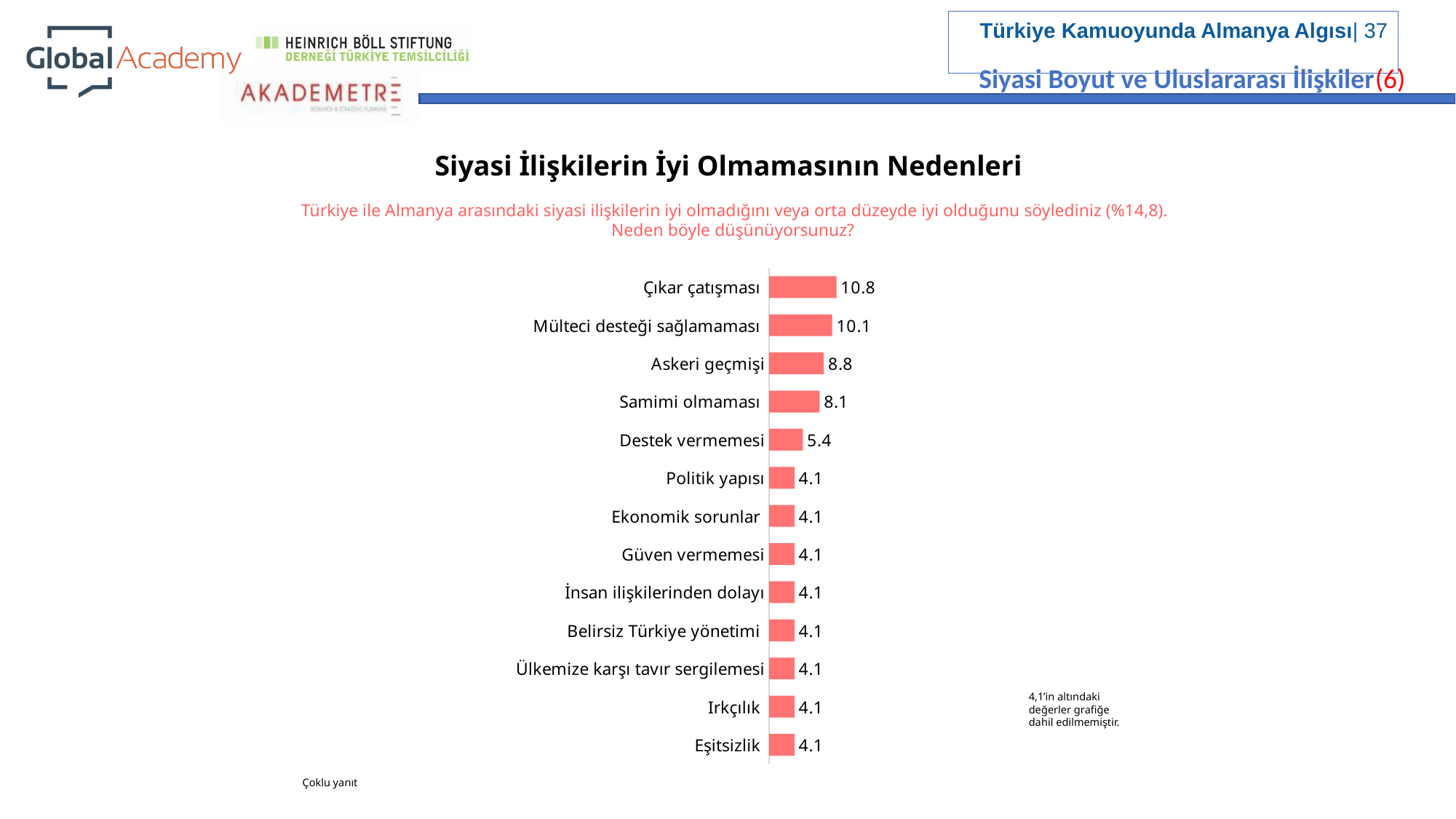
What is the difference between the values for Çıkar çatışması and Mülteci desteği sağlamaması? 0.7 What is the value for Çıkar çatışması? 10.8 What is the value for Mülteci desteği sağlamaması? 10.1 What kind of chart is shown on the slide? Bar chart Which category has the highest value? Çıkar çatışması What is the difference between the values for Askeri geçmişi and Destek vermemesi? 3.4 What is the value for Irkçılık? 4.1 What is the value for Askeri geçmişi? 8.8 Which is larger, the value for Samimi olmaması or the value for Destek vermemesi? Samimi olmaması How many categories are shown in the chart? 13 What is the lowest value shown in the chart? 4.1 What is the value for Destek vermemesi? 5.4